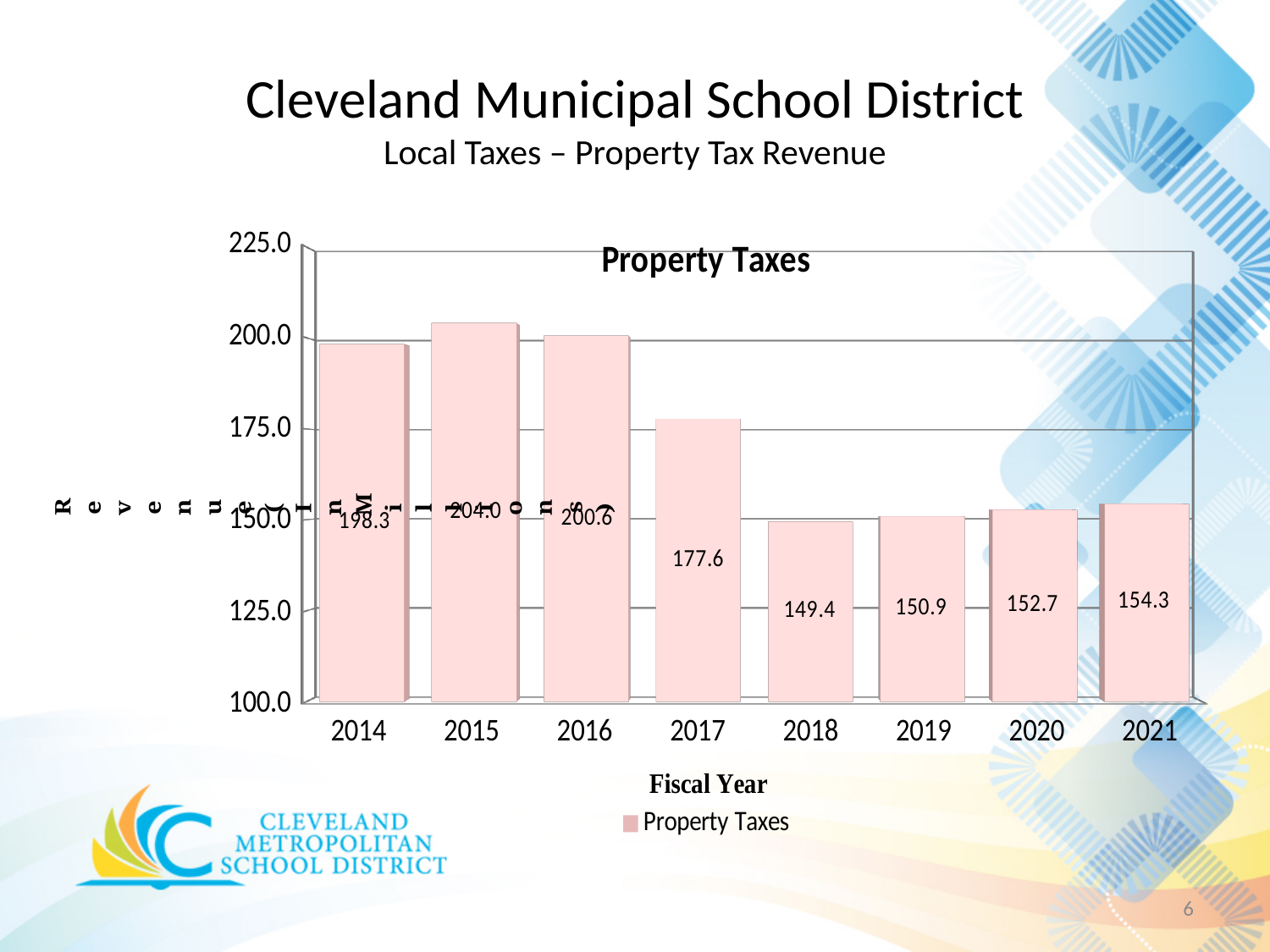
What type of chart is shown on the slide? Bar chart What is the difference between the Property Taxes values for 2015 and 2018? 54.6 What is the Property Taxes value for fiscal year 2017? 177.6 Which fiscal year has the highest Property Taxes value? 2015 How many fiscal years are shown on the x axis? 8 What is the Property Taxes value for fiscal year 2021? 154.3 Do the Property Taxes values rise or fall from 2018 to 2021? Rise Which fiscal year has the lowest Property Taxes value? 2018 What is the Property Taxes value for fiscal year 2014? 198.3 How many series does the legend list? 1 What is the difference between the Property Taxes values for 2016 and 2017? 23.0 Which fiscal year has a larger Property Taxes value, 2014 or 2020? 2014